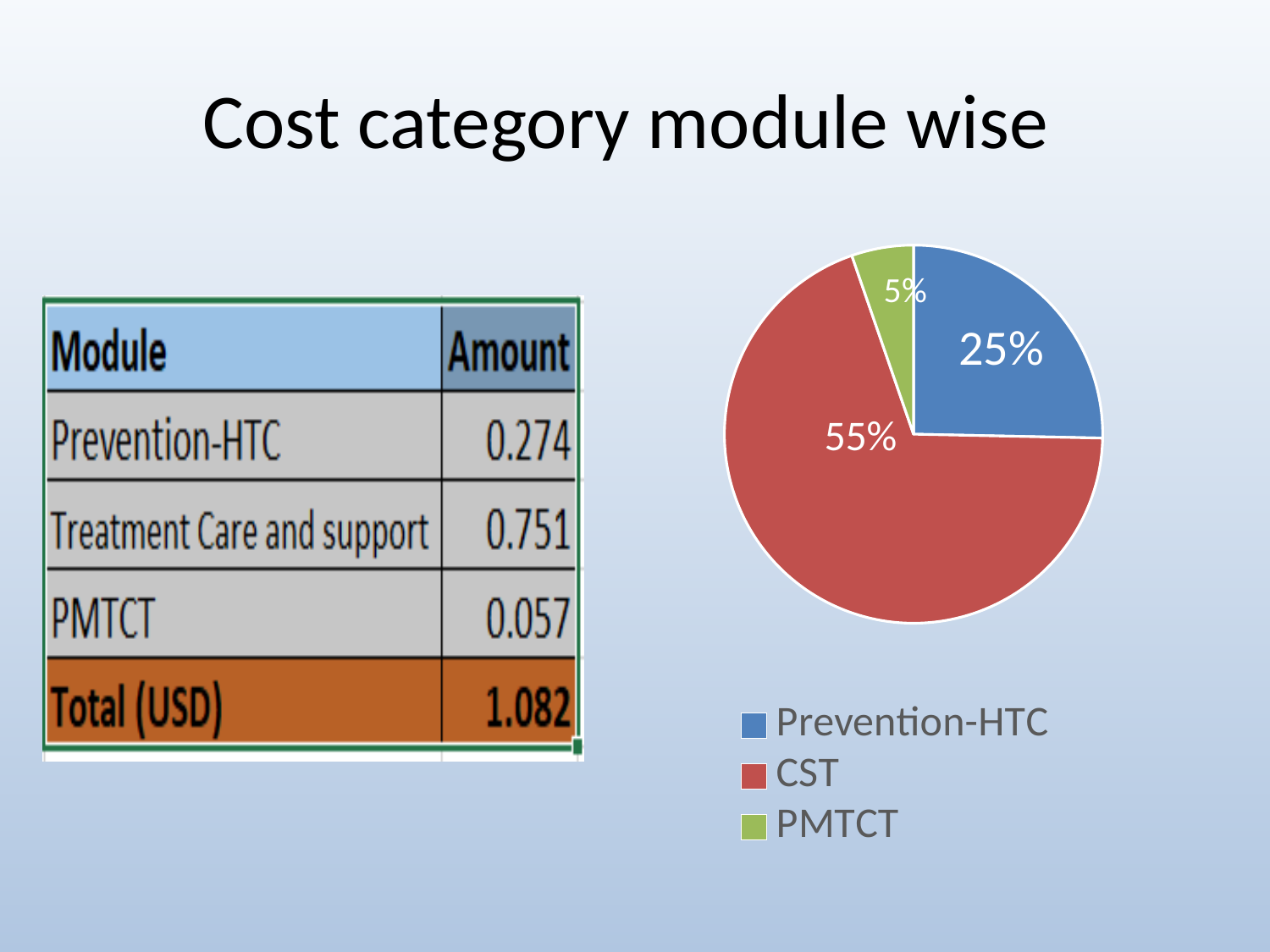
Which is larger, the slice for Prevention-HTC or the slice for PMTCT? Prevention-HTC Which category has the largest slice of the pie? CST What is the title of the slide containing the pie chart? Cost category module wise How many slices does the pie chart have? 3 What is the difference in percentage points between the CST slice and the Prevention-HTC slice? 30% How many entries does the legend list? 3 What share of the pie does Prevention-HTC represent? 25% What colour is the CST slice in the pie chart? red What share of the pie does PMTCT represent? 5% What share of the pie does CST represent? 55% What kind of chart is shown on the slide? pie chart Which category has the smallest slice of the pie? PMTCT